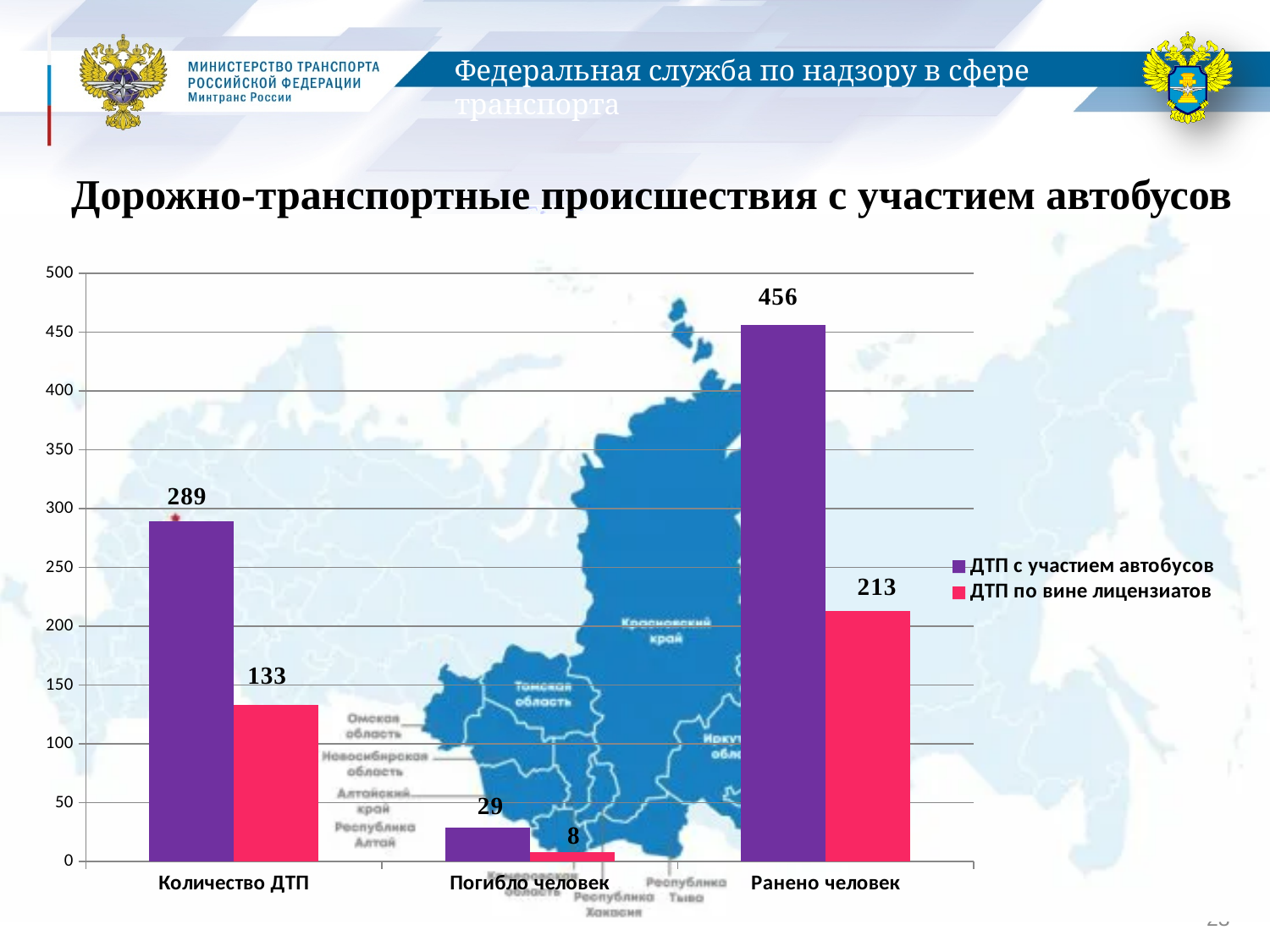
Which is larger: 'ДТП с участием автобусов' for 'Количество ДТП' or 'ДТП по вине лицензиатов' for 'Ранено человек'? ДТП с участием автобусов for Количество ДТП Is the value of 'ДТП с участием автобусов' for 'Ранено человек' greater or less than 400? greater Which category has the highest value for 'ДТП с участием автобусов'? Ранено человек How many categories are shown on the x axis? 3 Which category has the lowest value for 'ДТП по вине лицензиатов'? Погибло человек What is the value of 'ДТП с участием автобусов' for 'Количество ДТП'? 289 How many series does the legend list? 2 What is the value of 'ДТП по вине лицензиатов' for 'Ранено человек'? 213 What is the difference between 'ДТП с участием автобусов' and 'ДТП по вине лицензиатов' for 'Количество ДТП'? 156 What kind of chart is shown on the slide? bar chart What is the value of 'ДТП по вине лицензиатов' for 'Погибло человек'? 8 What is the difference between 'ДТП с участием автобусов' and 'ДТП по вине лицензиатов' for 'Ранено человек'? 243